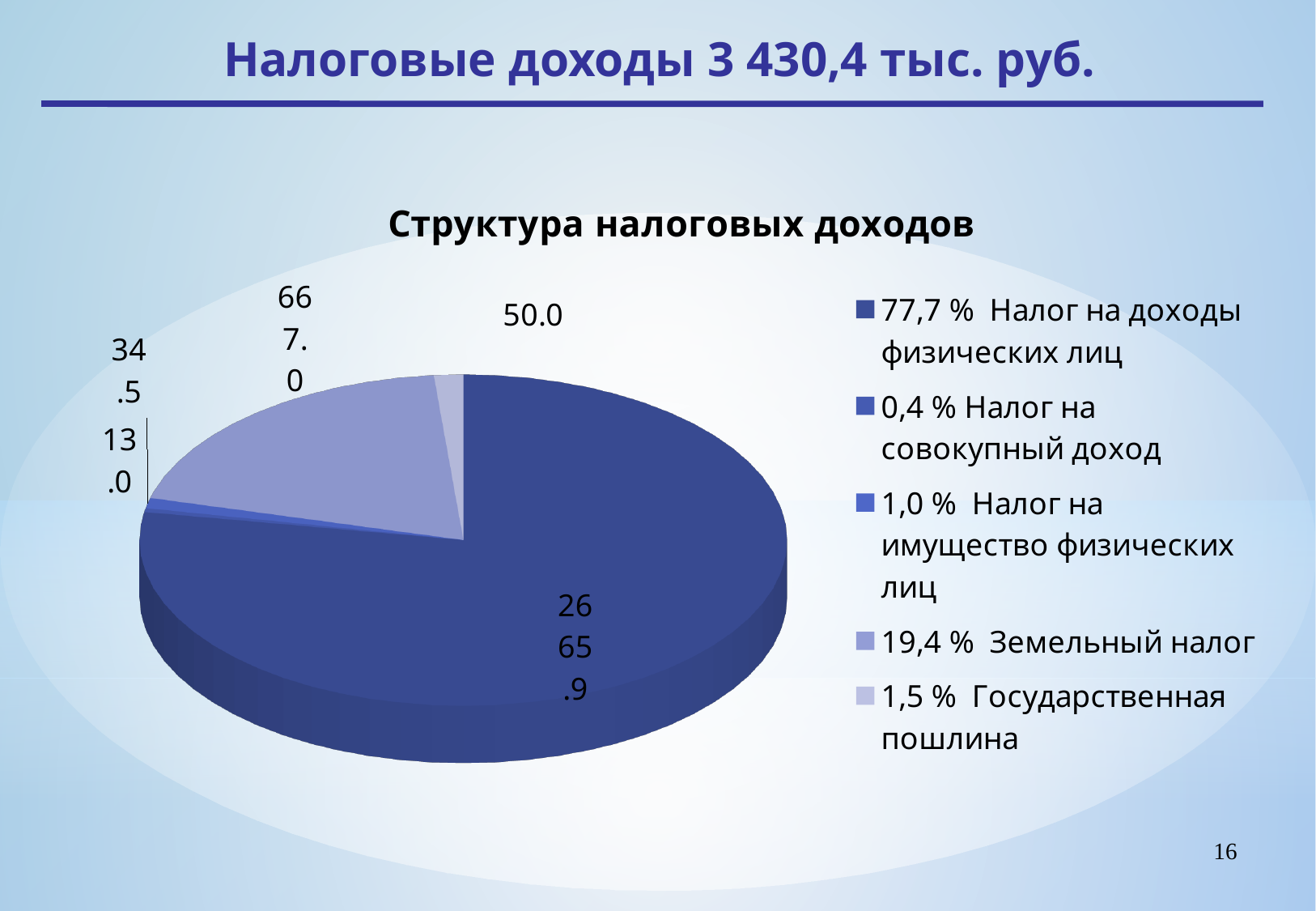
How many categories does the pie chart show? 5 What share of the pie does Государственная пошлина have? 1,5 % What is the value shown for Земельный налог? 667.0 What is the value shown for Налог на доходы физических лиц? 2665.9 Which is larger, the value for Земельный налог or the value for Государственная пошлина? Земельный налог What kind of chart is shown on the slide? pie chart What share of the pie does Земельный налог have? 19,4 % What is the value shown for Государственная пошлина? 50.0 Which category has the smallest slice of the pie? Налог на совокупный доход What share of the pie does Налог на имущество физических лиц have? 1,0 % Which category has the largest slice of the pie? Налог на доходы физических лиц What is the title of the chart? Структура налоговых доходов